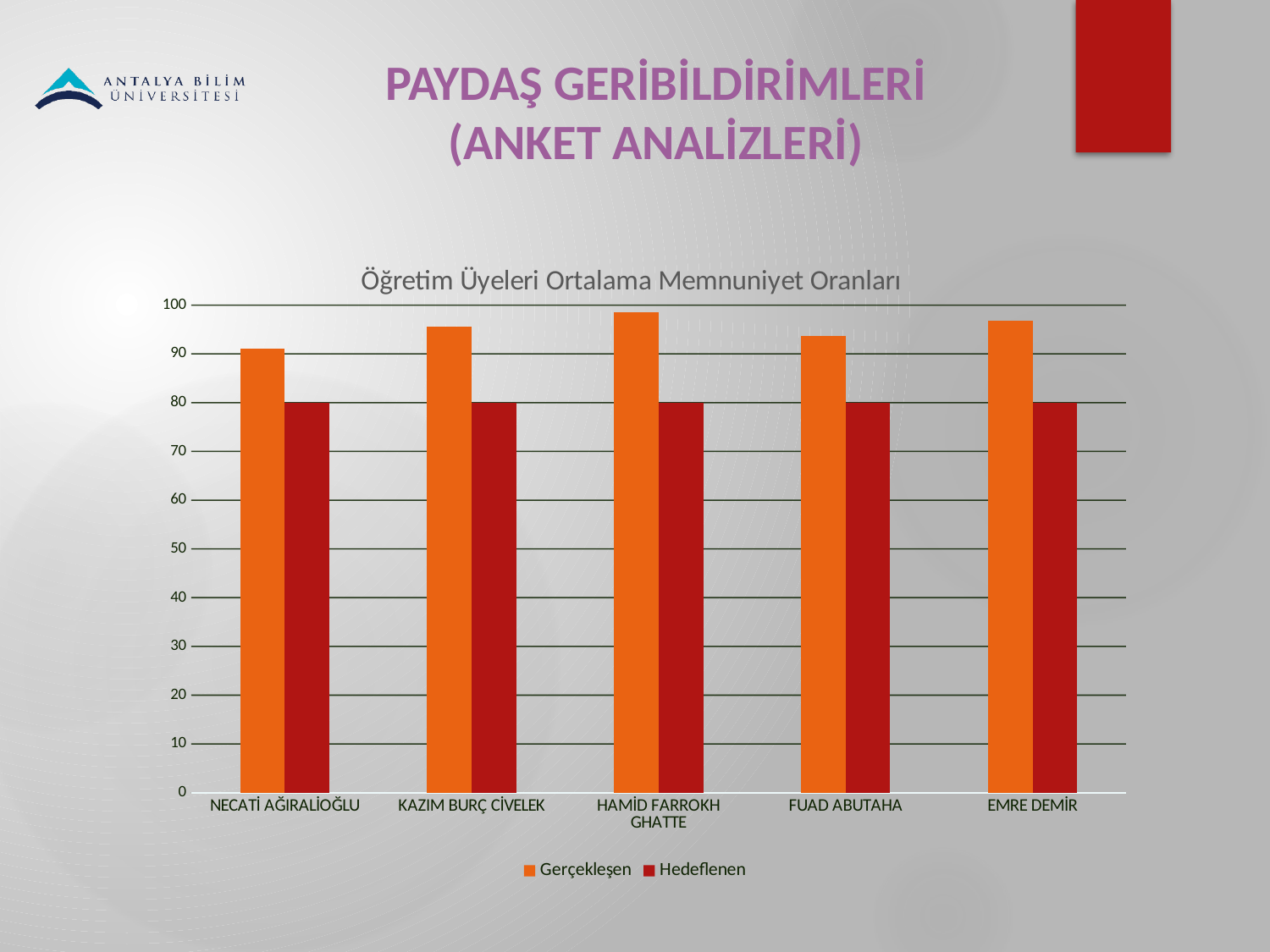
Is the Gerçekleşen value for FUAD ABUTAHA greater or less than 90? greater What is the Hedeflenen value for NECATİ AĞIRALİOĞLU? 80 For HAMİD FARROKH GHATTE, which is larger: Gerçekleşen or Hedeflenen? Gerçekleşen Which faculty member has the lowest Gerçekleşen value? NECATİ AĞIRALİOĞLU How many series does the legend list? 2 Which series is shown in dark red in the legend? Hedeflenen What kind of chart is shown on the slide? Bar chart How many categories (faculty members) are shown on the x axis? 5 What is the title of the chart? Öğretim Üyeleri Ortalama Memnuniyet Oranları Which has the larger Gerçekleşen value: HAMİD FARROKH GHATTE or NECATİ AĞIRALİOĞLU? HAMİD FARROKH GHATTE Is the Gerçekleşen value for KAZIM BURÇ CİVELEK greater or less than 90? greater What is the Hedeflenen value for EMRE DEMİR? 80